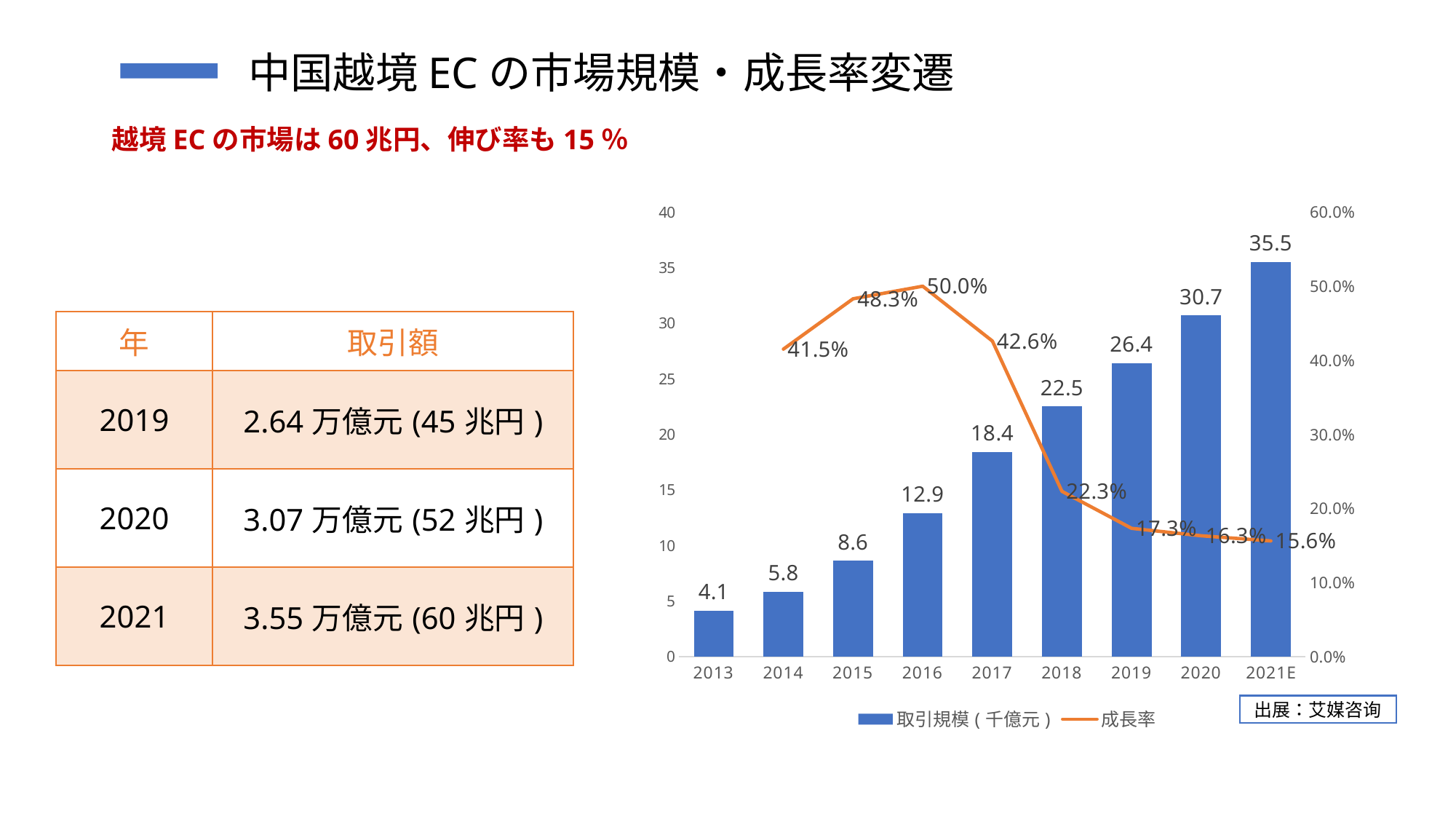
What is the difference between the 取引規模 (千億元) values for 2020 and 2019? 4.3 Which year has the highest 成長率 value? 2016 Which is larger, the 成長率 for 2015 or for 2017? 2015 What is the 成長率 value for 2016? 50.0% How many years are shown on the x axis of the chart? 9 Does the 取引規模 (千億元) series rise or fall from 2013 to 2021E? rise Which year has the lowest 成長率 value? 2021E What is the 取引規模 (千億元) value for 2017? 18.4 What is the 成長率 value for 2021E? 15.6% Which year has the highest 取引規模 (千億元) value? 2021E Is the 取引規模 (千億元) value for 2018 greater or less than 20? greater How many series does the chart legend list? 2